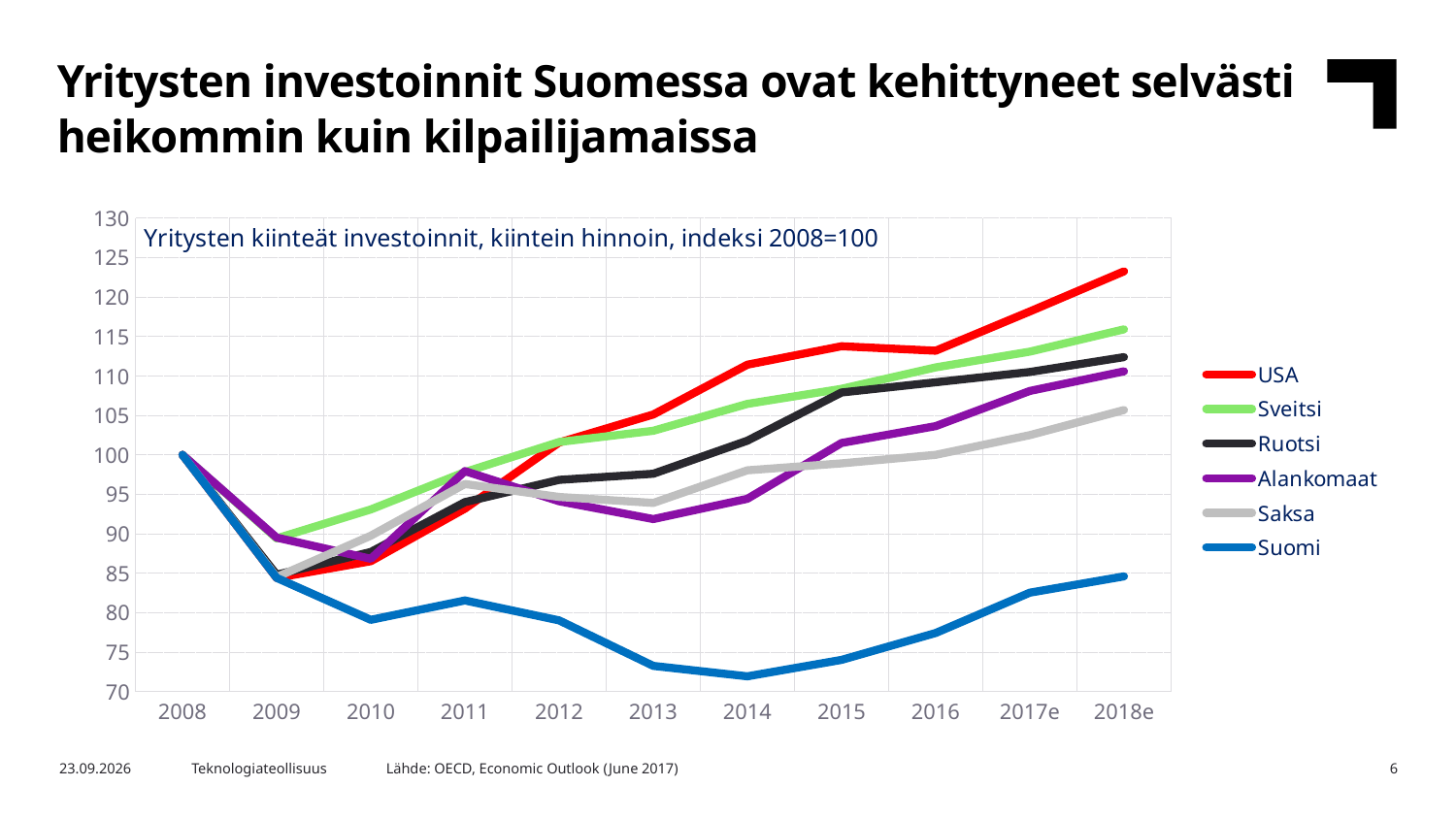
What kind of chart is shown on the slide? line chart Which series has the highest value in 2018e? USA What is the title printed inside the chart area? Yritysten kiinteät investoinnit, kiintein hinnoin, indeksi 2008=100 How many series does the legend list? 6 In 2016, which is larger: the value for USA or the value for Suomi? USA How many years are shown on the x axis? 11 Which series has the lowest value in 2018e? Suomi Is the value for Saksa in 2018e greater or less than 110? less Is the value for Suomi in 2014 greater or less than 75? less Does the value for Suomi rise or fall from 2008 to 2014? fall What is the index value for Suomi in 2008? 100 Is the value for USA in 2018e greater or less than 120? greater